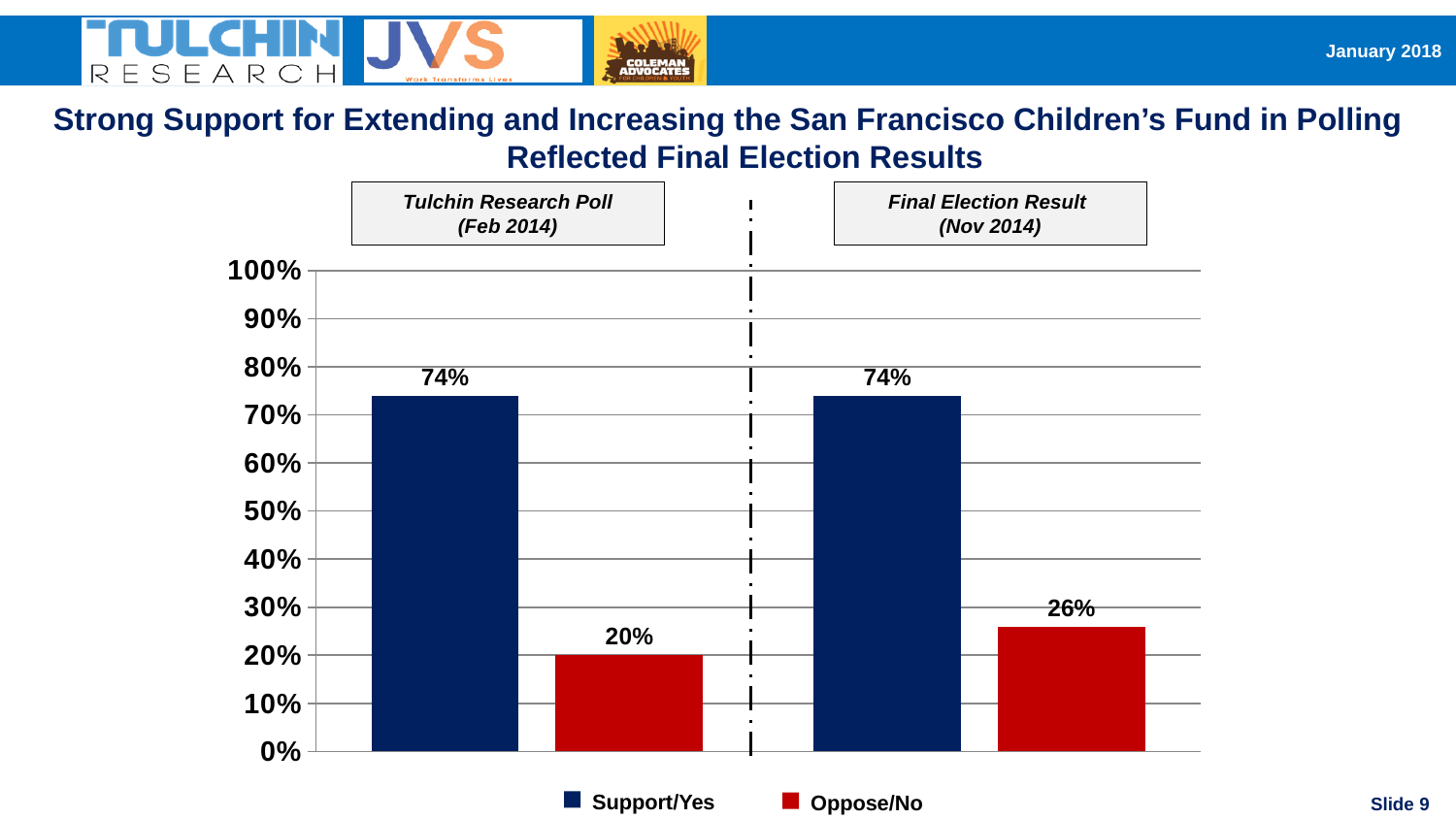
What is the Oppose/No value in the Tulchin Research Poll (Feb 2014)? 20% What is the Support/Yes value in the Final Election Result (Nov 2014)? 74% Which group has the lowest value on the chart? Oppose/No in the Tulchin Research Poll (Feb 2014) What kind of chart is shown on the slide? Bar chart What is the Oppose/No value in the Final Election Result (Nov 2014)? 26% What is the difference between Support/Yes and Oppose/No in the Tulchin Research Poll (Feb 2014)? 54% How many series does the legend list? 2 Which is larger: Oppose/No in the Tulchin Research Poll or Oppose/No in the Final Election Result? Final Election Result What colour represents Support/Yes in the legend? Dark blue What is the total of Support/Yes and Oppose/No in the Final Election Result (Nov 2014)? 100% What is the Support/Yes value in the Tulchin Research Poll (Feb 2014)? 74% What is the difference between the Oppose/No values in the Final Election Result and the Tulchin Research Poll? 6%